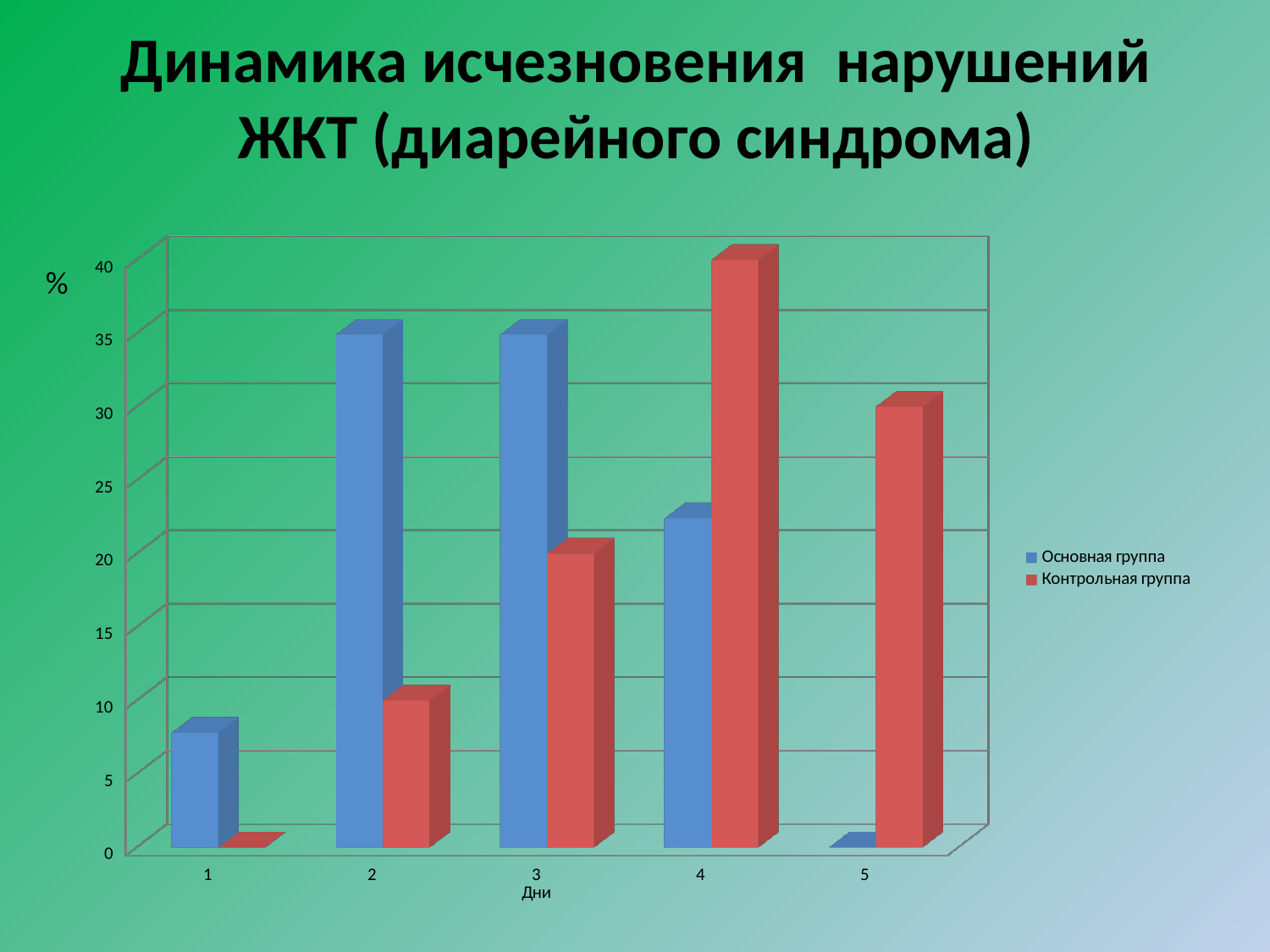
On day 2, which series has the larger value, Основная группа or Контрольная группа? Основная группа On which day is the value for Основная группа lowest? 5 Is the value for Основная группа on day 1 greater or less than 10? less What kind of chart is shown on the slide? bar chart Is the value for Контрольная группа on day 4 greater or less than 35? greater How many series does the legend list? 2 How many days (categories) are shown on the x axis? 5 On which day is the value for Контрольная группа highest? 4 What are the two series named in the legend? Основная группа, Контрольная группа Do the values for Контрольная группа rise or fall from day 1 to day 4? rise On day 5, which series has the larger value, Основная группа or Контрольная группа? Контрольная группа What is the label of the x axis? Дни